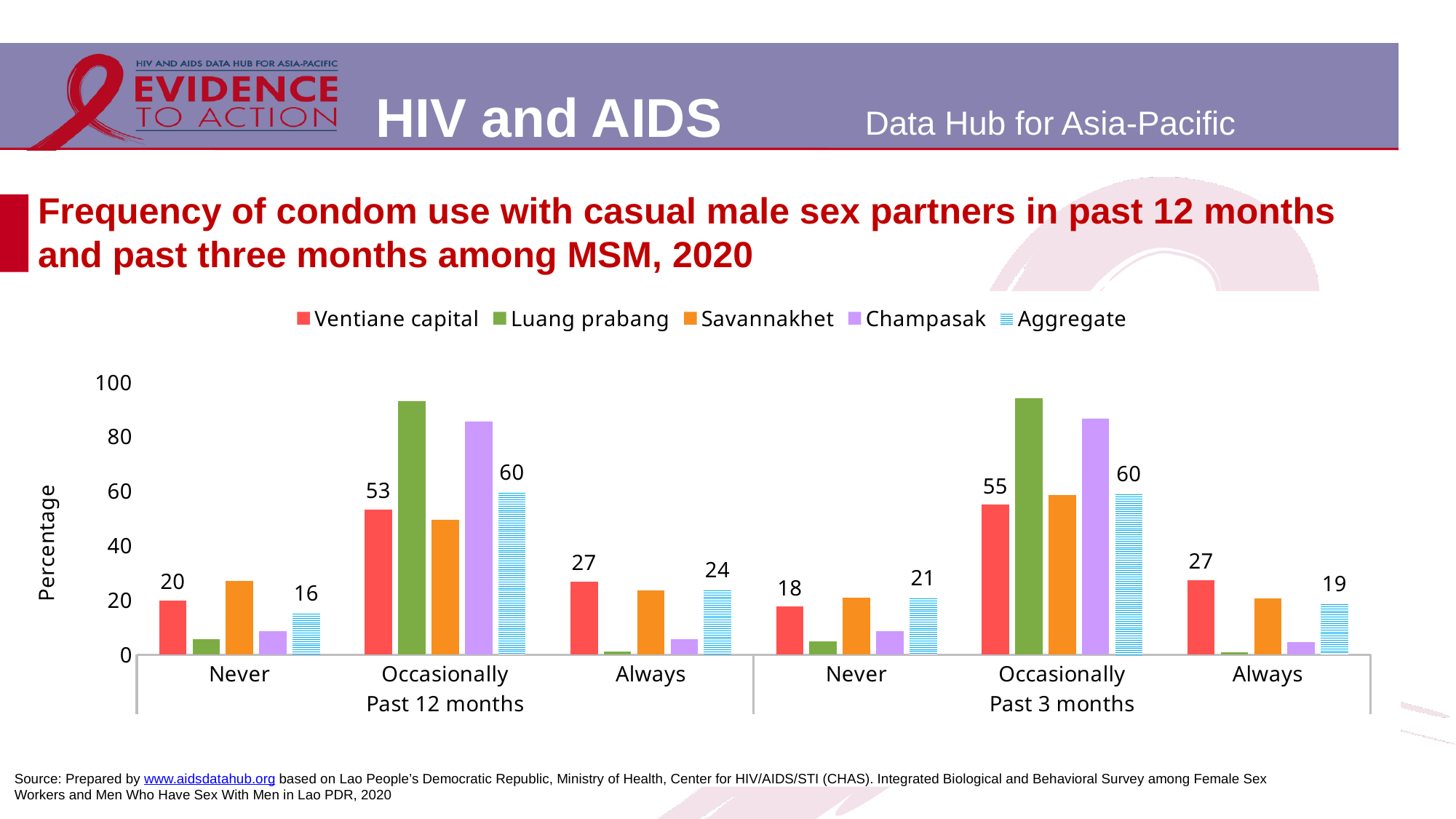
Which series has the highest value for 'Occasionally' in the past 3 months? Luang prabang What is the value for Ventiane capital for 'Never' in the past 3 months? 18 What is the Aggregate value for 'Always' in the past 12 months? 24 Which is larger for 'Always' in the past 3 months: Ventiane capital or Aggregate? Ventiane capital What type of chart is shown on the slide? bar chart What is the Aggregate value for 'Occasionally' in the past 3 months? 60 How many series does the legend list? 5 Which series has the lowest value for 'Always' in the past 12 months? Luang prabang What is the value for Ventiane capital for 'Occasionally' in the past 12 months? 53 What is the difference between the Aggregate value and the Ventiane capital value for 'Occasionally' in the past 12 months? 7 Is the value for Champasak for 'Never' in the past 12 months greater or less than 20? less Is the value for Luang prabang for 'Occasionally' in the past 12 months greater or less than 80? greater